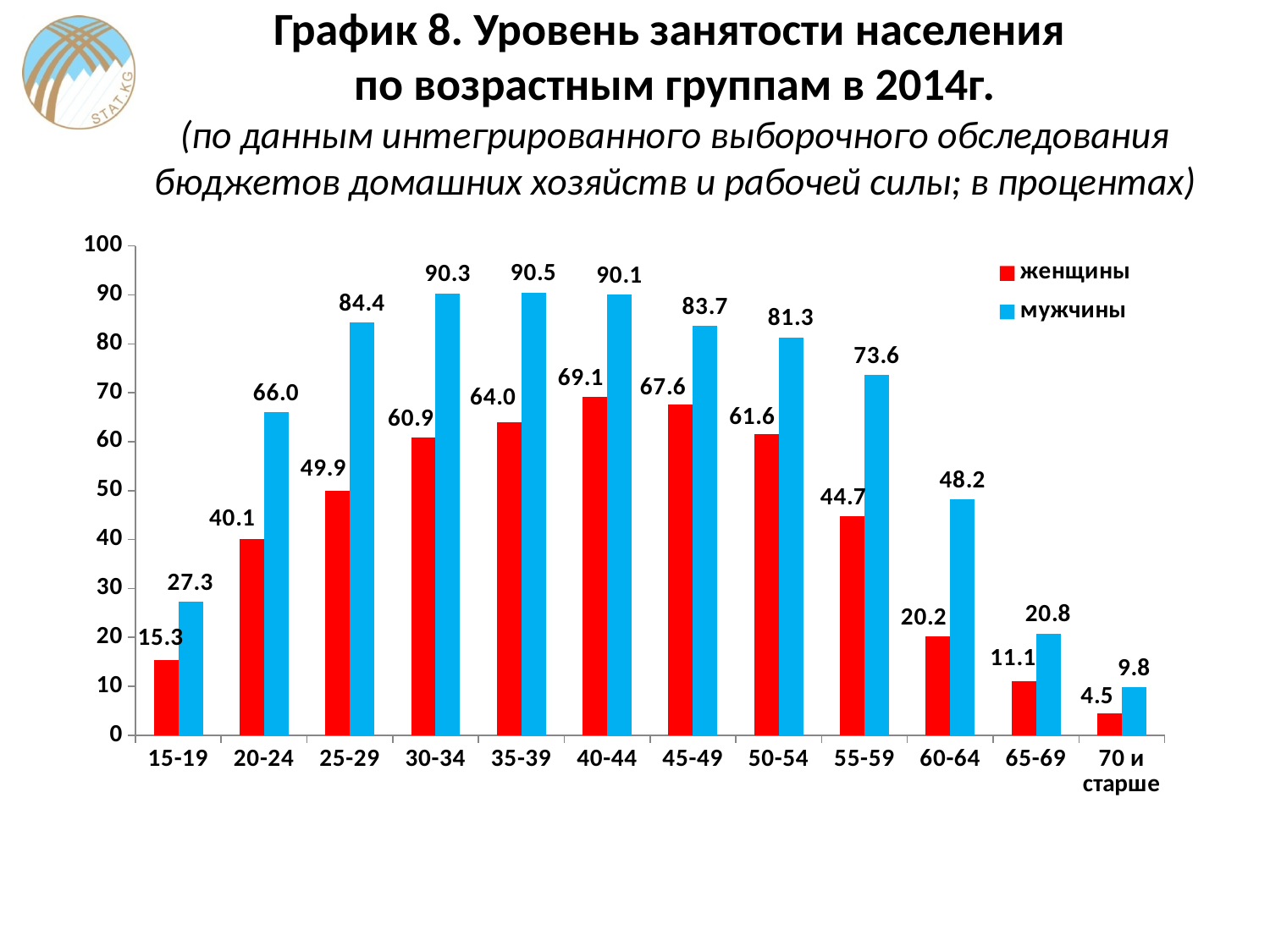
How many series does the legend list? 2 What is the employment rate for men (мужчины) in the 25-29 age group? 84.4 Which age group has the highest employment rate for women (женщины)? 40-44 What is the difference between the men's and women's employment rates in the 15-19 age group? 12.0 What kind of chart is shown on the slide? Bar chart What is the employment rate for women (женщины) in the 40-44 age group? 69.1 Which age group has the highest employment rate for men (мужчины)? 35-39 How many age groups are shown on the x axis? 12 What is the difference between the men's and women's employment rates in the 40-44 age group? 21.0 Which is larger: the women's rate in the 45-49 age group or the women's rate in the 50-54 age group? 45-49 Which age group has the lowest employment rate for women (женщины)? 70 и старше What is the value for women (женщины) in the 70 и старше age group? 4.5